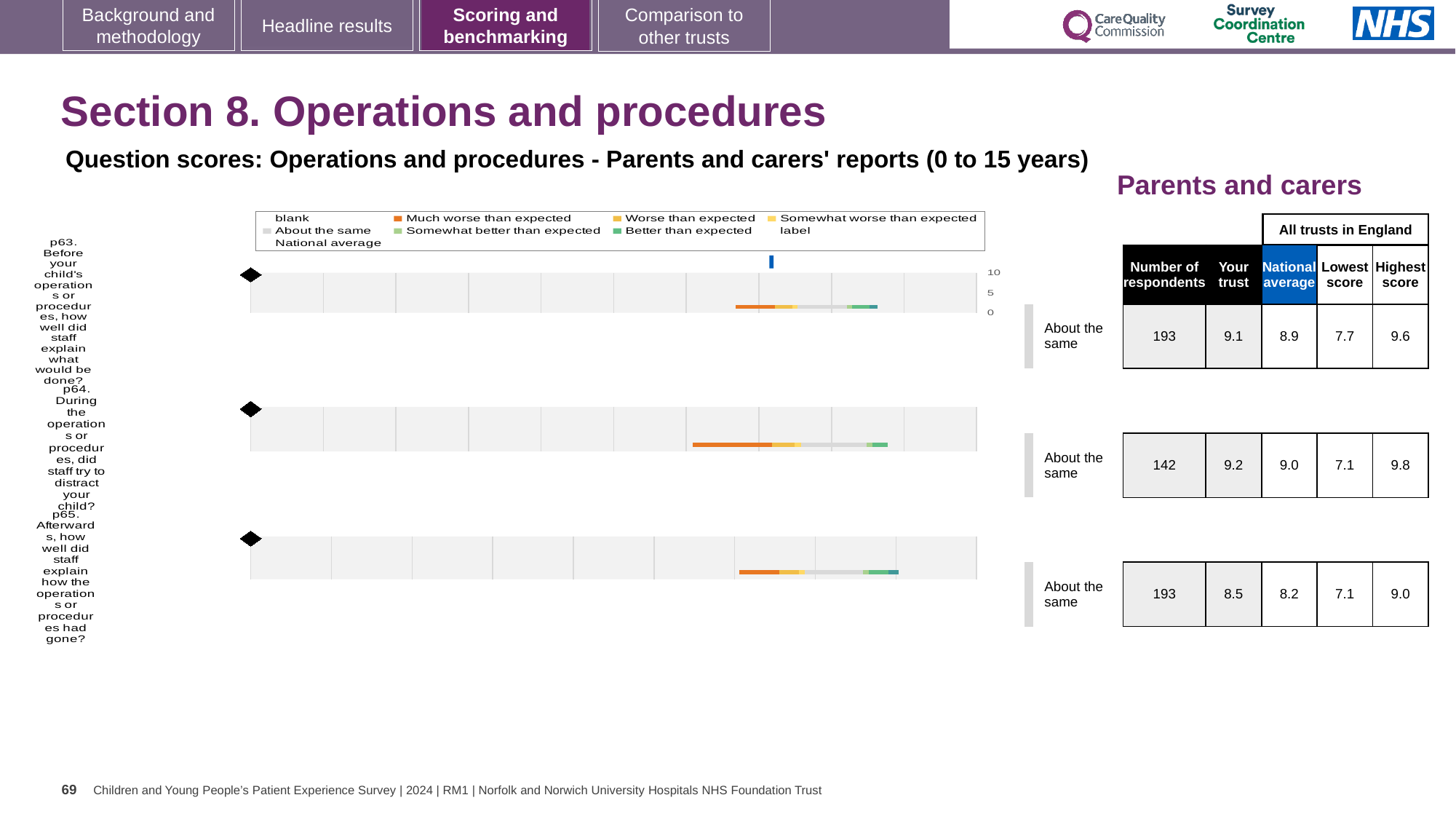
What is the 'Your trust' score for p63 (Before your child's operations or procedures, how well did staff explain what would be done?)? 9.1 What is the national average score for p64 (During the operations or procedures, did staff try to distract your child?)? 9.0 Which question has the lowest 'Your trust' score? p65 What is the difference between the highest and lowest trust scores in England for p64? 2.7 What benchmark category is shown for all three questions? About the same Which question has the highest 'Your trust' score? p64 For p64, which is larger: the trust's score or the national average? Your trust (9.2) How many questions are charted on this slide? 3 How many respondents answered p65 (Afterwards, how well did staff explain how the operations or procedures had gone?)? 193 What is the highest score across all trusts in England for p64? 9.8 By how much does the trust's score for p65 exceed the national average for p65? 0.3 What is the lowest score across all trusts in England for p63? 7.7